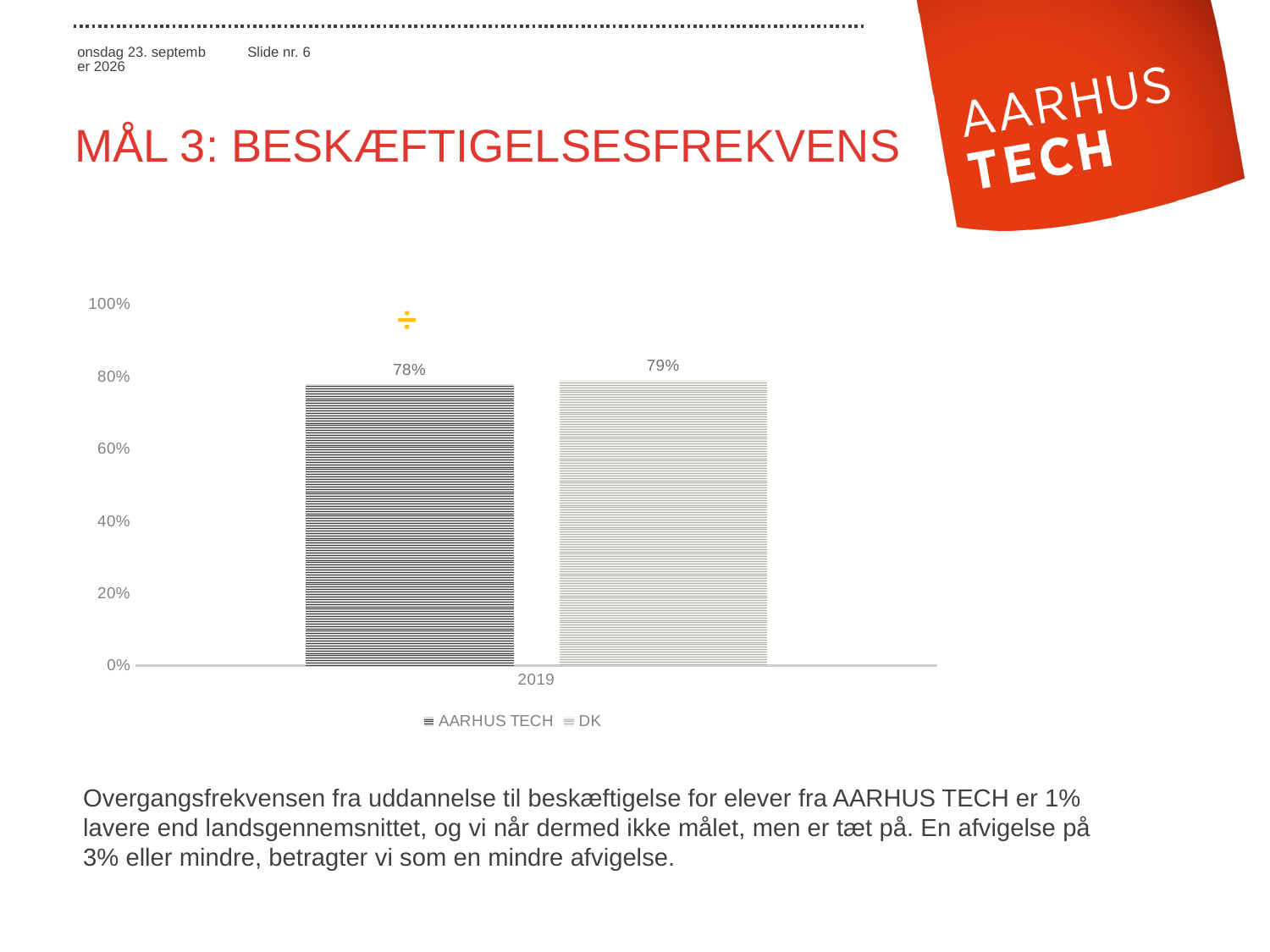
Is the value for DK greater or less than 60%? greater What is the value for AARHUS TECH in 2019? 78% Is the value for AARHUS TECH greater or less than 80%? less What is the value for DK in 2019? 79% How many series does the legend list? 2 Which year is shown on the x axis of the chart? 2019 What is the difference between the DK value and the AARHUS TECH value in 2019? 1% How many categories are shown on the x axis? 1 What kind of chart is shown on the slide? bar chart Which series has the lowest value in the chart? AARHUS TECH Which series has the higher value in 2019, AARHUS TECH or DK? DK What are the two series named in the legend? AARHUS TECH and DK